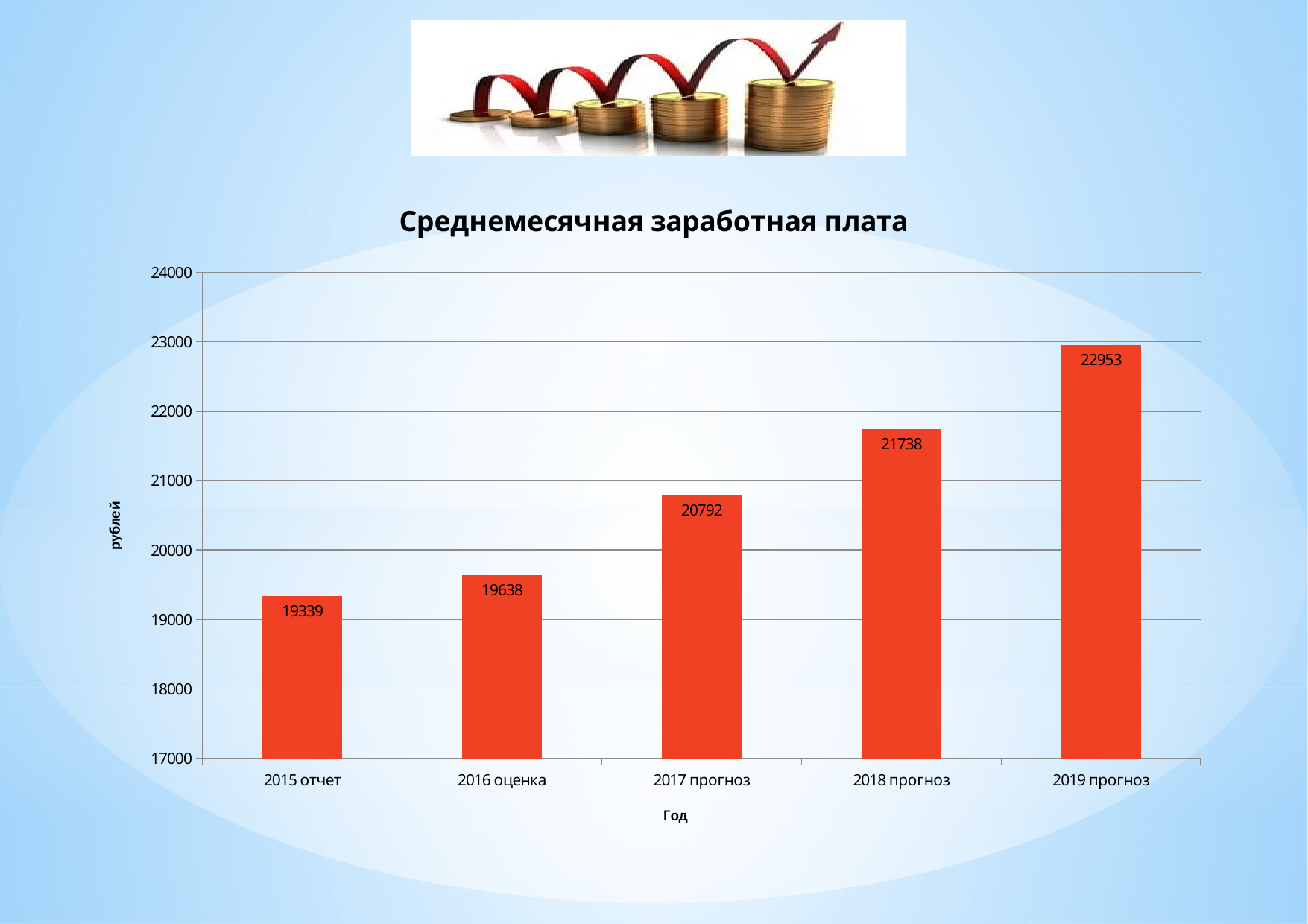
Which category has the highest value? 2019 прогноз Do the values rise or fall from 2015 отчет to 2019 прогноз? rise What kind of chart is shown on the slide? bar chart Which category has the lowest value? 2015 отчет Is the value for 2018 прогноз greater or less than 21000? greater What is the difference between the values for 2019 прогноз and 2018 прогноз? 1215 Which is larger, the value for 2017 прогноз or the value for 2016 оценка? 2017 прогноз What is the value for 2017 прогноз? 20792 What is the value for 2015 отчет? 19339 What is the difference between the values for 2016 оценка and 2015 отчет? 299 How many categories are shown on the x axis? 5 What is the value for 2019 прогноз? 22953